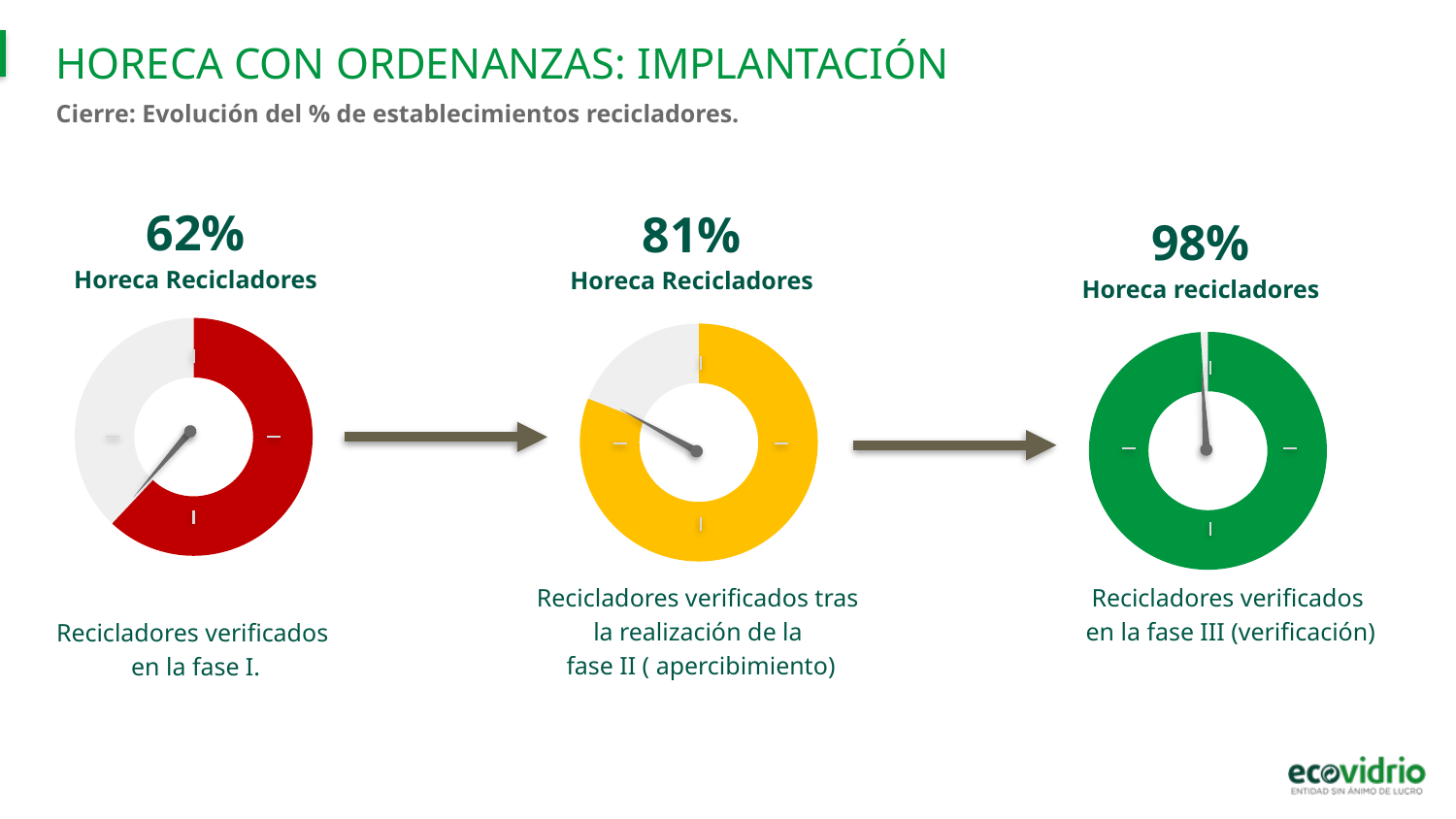
How many gauge charts are shown on the slide? 3 Which phase shows the highest percentage of Horeca recicladores? Fase III (98%) What is the difference in the percentage of Horeca recicladores between fase III and fase I? 36 percentage points Which phase shows the lowest percentage of Horeca recicladores? Fase I (62%) By how many percentage points did the share of Horeca recicladores increase from fase II to fase III? 17 percentage points By how many percentage points did the share of Horeca recicladores increase from fase I to fase II? 19 percentage points On the middle chart (fase II, apercibimiento), what percentage of Horeca establishments are recicladores? 81% What kind of chart is used to show the percentage of Horeca recicladores in each phase? Doughnut (gauge) chart Which is larger, the percentage of Horeca recicladores in fase II or in fase I? Fase II On the right chart (fase III, verificación), what percentage of Horeca establishments are recicladores? 98% Does the percentage of Horeca recicladores rise or fall from fase I to fase III? Rise On the left chart (fase I), what percentage of Horeca establishments are recicladores? 62%